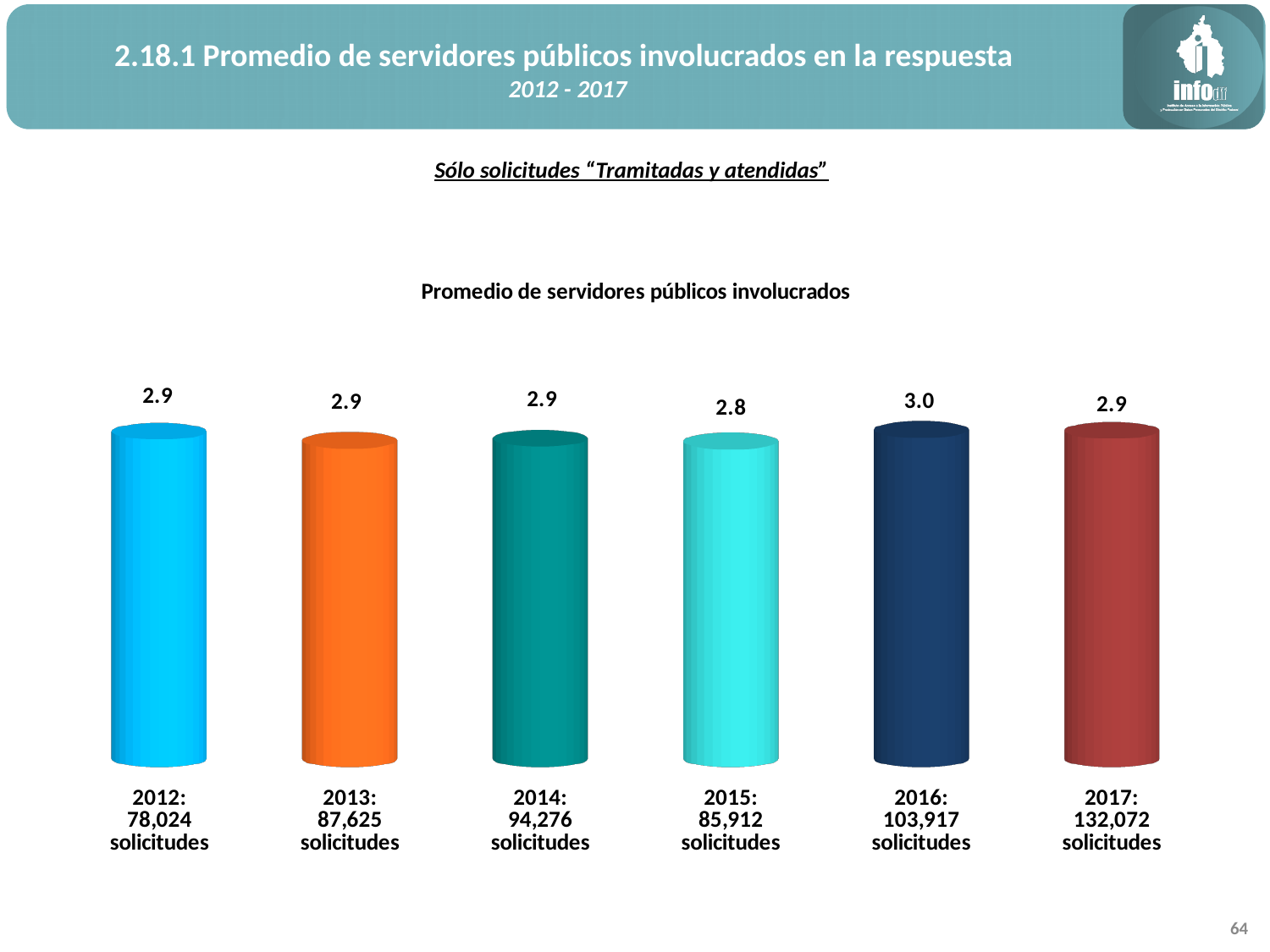
What is the title of the chart? Promedio de servidores públicos involucrados What is the difference between the values for 2016 and 2015? 0.2 What is the average number of public servants involved for 2012? 2.9 How many years are shown in the chart? 6 Which year has the highest average of public servants involved? 2016 How many solicitudes are listed under the 2017 bar? 132,072 What is the value shown for 2017? 2.9 What kind of chart is shown on the slide? bar chart Which year has the lowest average of public servants involved? 2015 Which is larger, the value for 2016 or the value for 2014? 2016 What is the value shown for 2015? 2.8 What is the value shown for 2016? 3.0